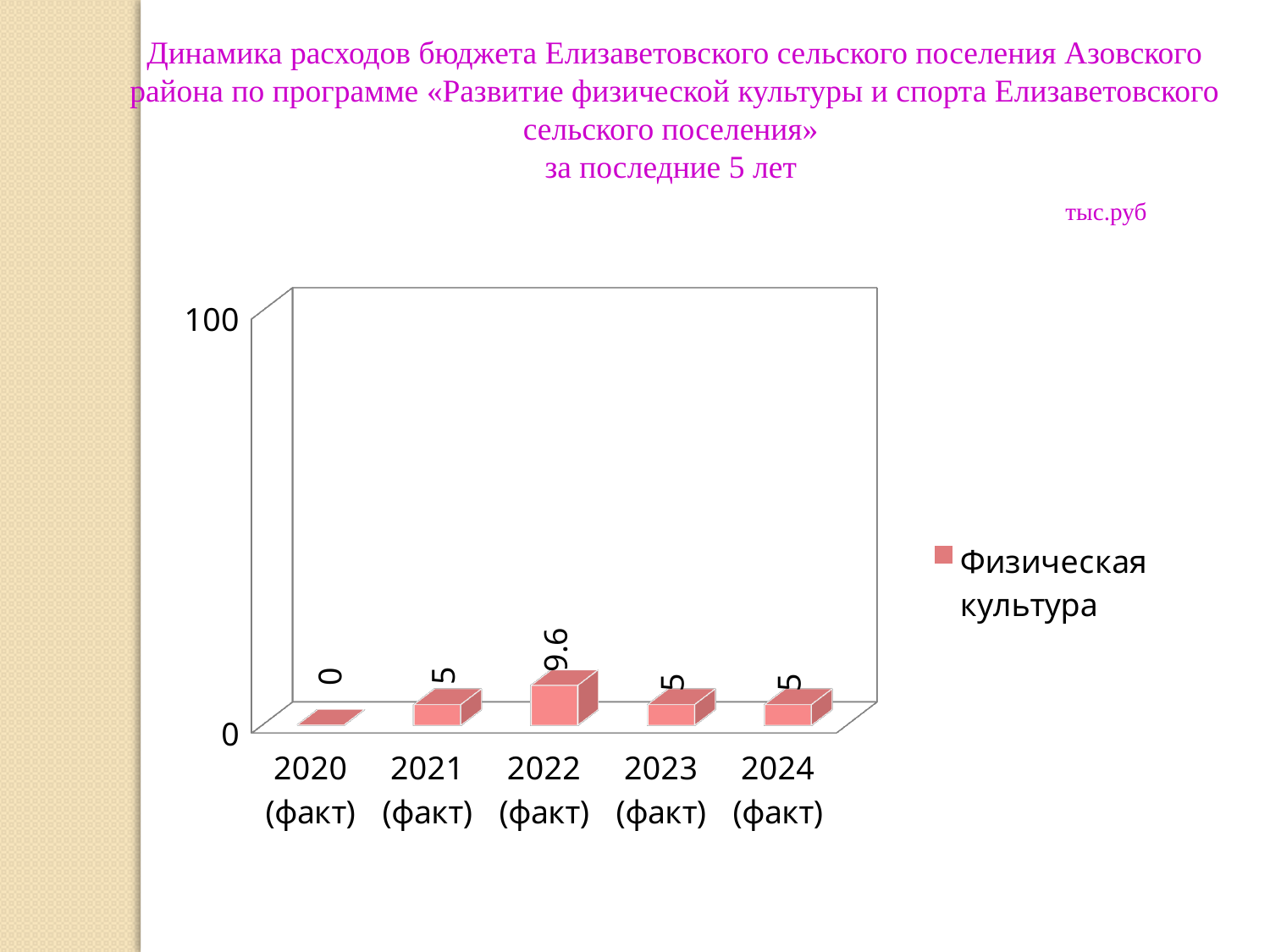
What is the value for 2021 (факт)? 5 What is the value for 2022 (факт)? 9.6 What is the value for 2024 (факт)? 5 Is the value for 2022 (факт) greater or less than 100? less How many years are shown on the x axis? 5 What is the difference between the values for 2022 (факт) and 2023 (факт)? 4.6 Which year has the lowest value? 2020 (факт) How many series does the legend list? 1 Which is larger, the value for 2022 (факт) or the value for 2021 (факт)? 2022 (факт) What is the value for 2020 (факт)? 0 Which year has the highest value? 2022 (факт) What kind of chart is shown on the slide? bar chart